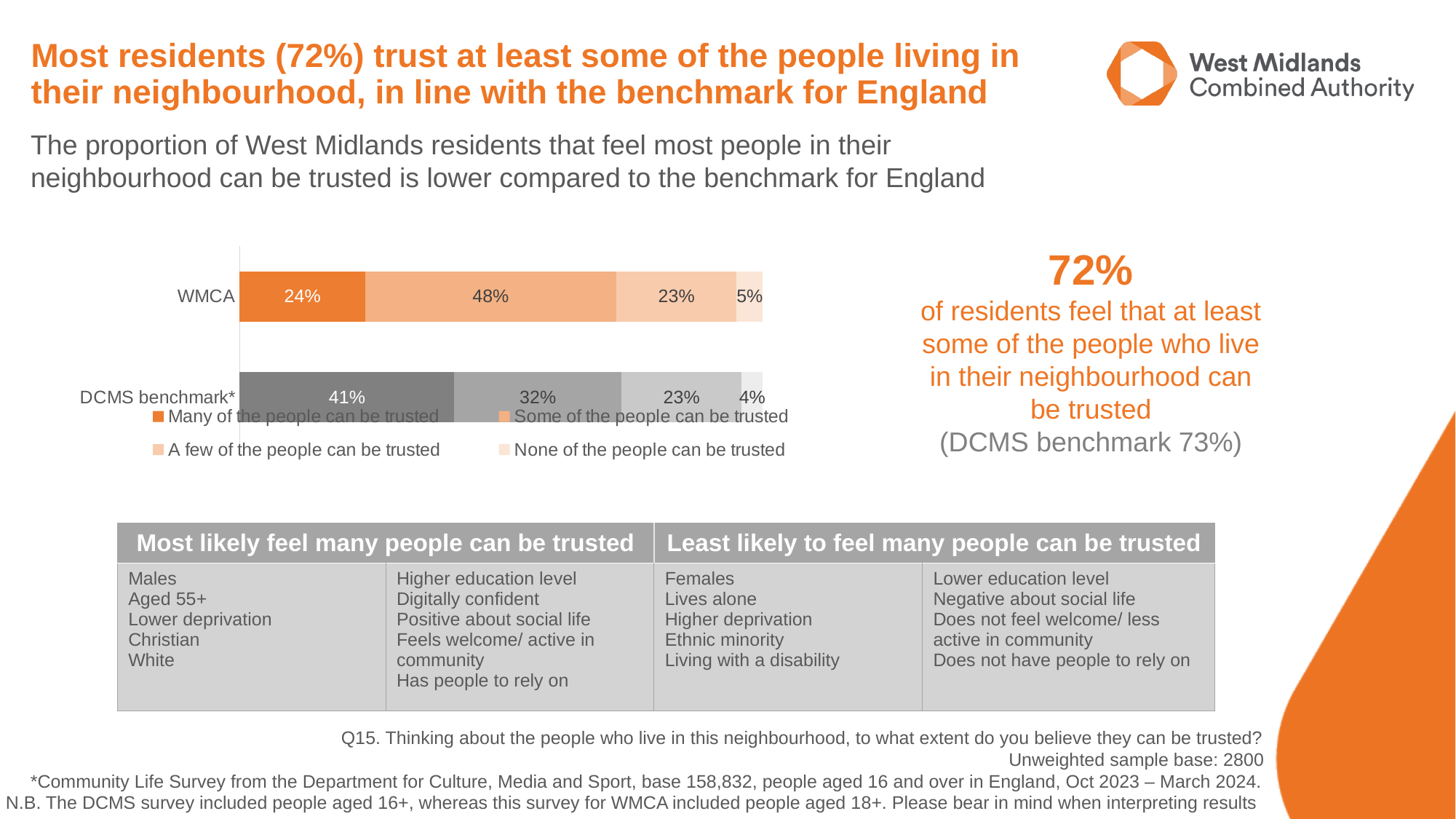
What is the DCMS benchmark value for 'None of the people can be trusted'? 4% What type of chart is shown on the slide? Stacked bar chart What is the difference between the DCMS benchmark and WMCA values for 'Many of the people can be trusted'? 17 percentage points Which is larger: the WMCA value or the DCMS benchmark value for 'Some of the people can be trusted'? WMCA What is the combined total of 'Many' and 'Some of the people can be trusted' for WMCA? 72% How many bars (categories) does the chart show? 2 Which segment is the smallest in the DCMS benchmark bar? None of the people can be trusted What is the DCMS benchmark value for 'Many of the people can be trusted'? 41% What percentage of WMCA residents say many of the people can be trusted? 24% Which segment is the largest in the WMCA bar? Some of the people can be trusted What percentage of WMCA residents say some of the people can be trusted? 48% How many series does the legend list? 4